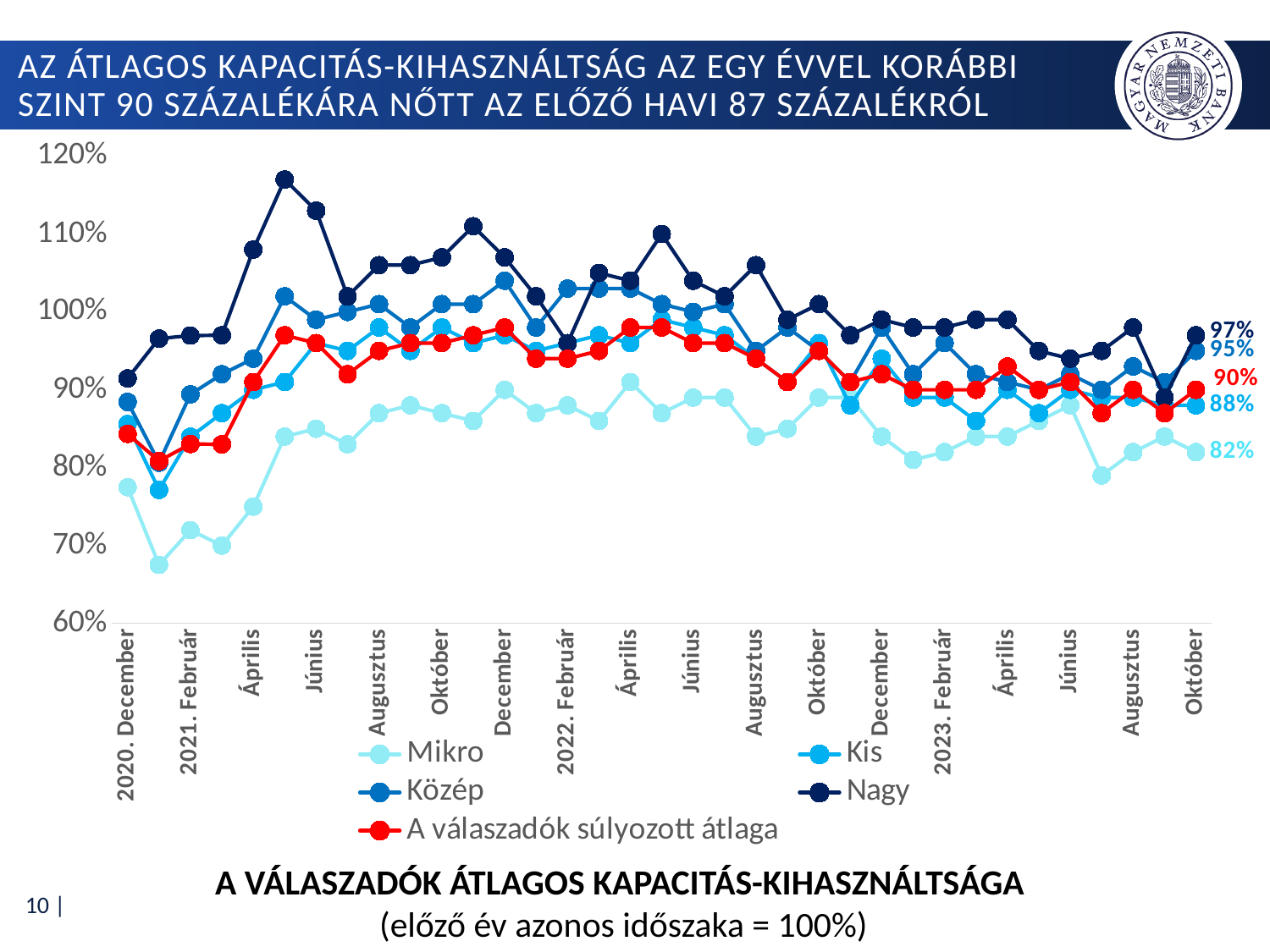
Which series has the lowest value at the last point (2023 Október)? Mikro What is the value for the Nagy series at the last point (2023 Október)? 97% Which series has the highest value at the last point (2023 Október)? Nagy What is the value for the Mikro series at the last point (2023 Október)? 82% What is the value for the Kis series at the last point (2023 Október)? 88% What is the value for 'A válaszadók súlyozott átlaga' at the last point (2023 Október)? 90% What is the title of the chart? A válaszadók átlagos kapacitás-kihasználtsága (előző év azonos időszaka = 100%) What is the difference between the Nagy and Mikro values at the last point (2023 Október)? 15 percentage points Is the highest value of the Nagy series (in 2021) greater or less than 110%? greater What kind of chart is shown on the slide? line chart At the last point (2023 Október), which is larger: the Közép value or the Kis value? Közép How many series does the legend list? 5